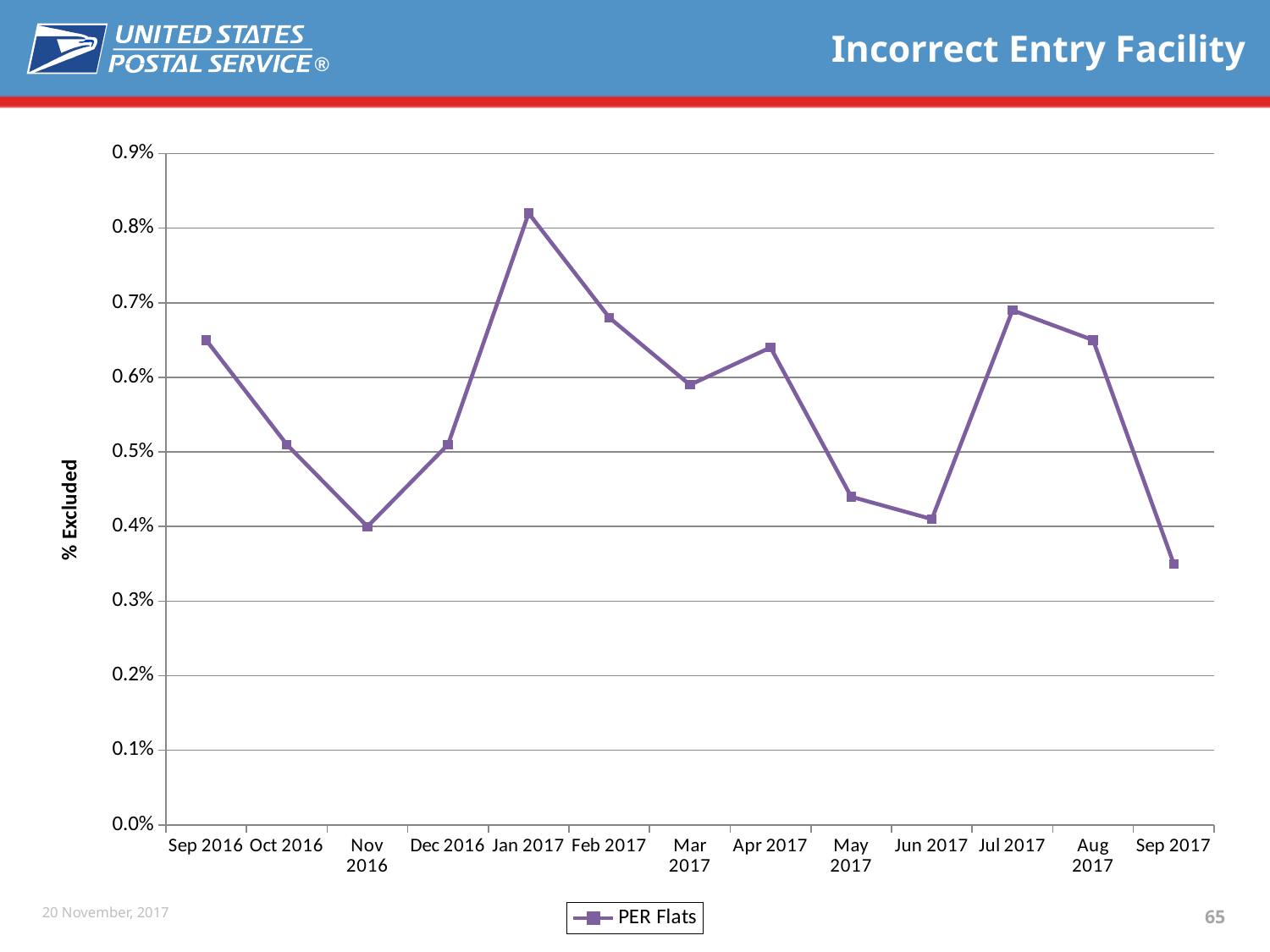
Is the value for Sep 2017 greater or less than 0.4%? less What is the name of the series shown in the legend? PER Flats What kind of chart is shown on the slide? line chart Which month has the lowest value for PER Flats? Sep 2017 Which is larger, the value for Feb 2017 or the value for Mar 2017? Feb 2017 Is the value for Jan 2017 greater or less than 0.8%? greater How many series does the legend list? 1 Which month has the highest value for PER Flats? Jan 2017 Is the value for May 2017 greater or less than 0.5%? less How many months are plotted along the x axis? 13 Do the values rise or fall from Jul 2017 to Sep 2017? fall What is the label on the vertical axis? % Excluded